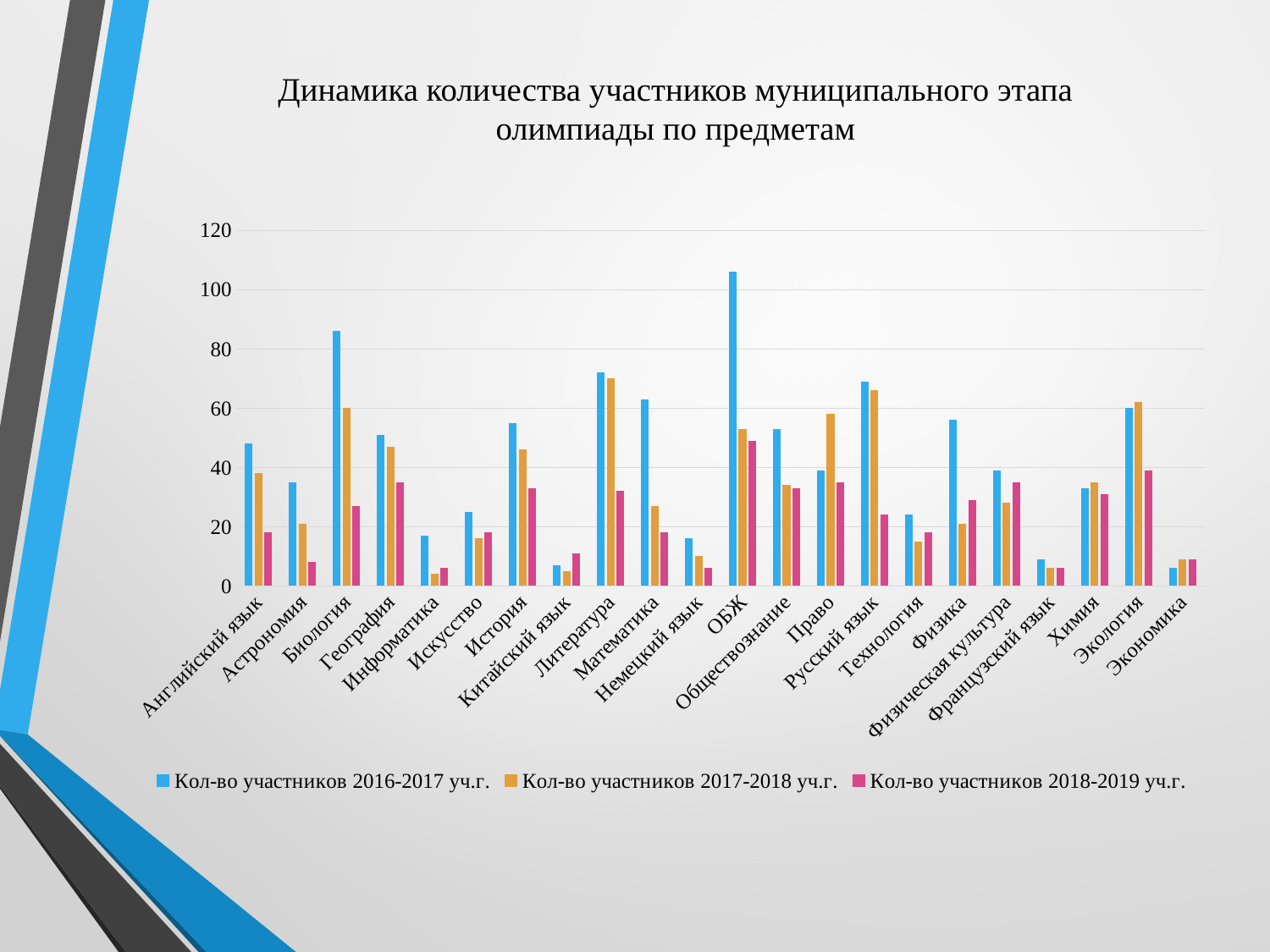
For Право, which series has the larger value: Кол-во участников 2016-2017 уч.г. or Кол-во участников 2017-2018 уч.г.? Кол-во участников 2017-2018 уч.г. Is the value for Право in Кол-во участников 2017-2018 уч.г. greater or less than 40? greater How many subject categories are shown on the x axis? 22 Which is larger for Кол-во участников 2016-2017 уч.г.: Биология or Экология? Биология Which subject has the highest value for Кол-во участников 2018-2019 уч.г.? ОБЖ What is the title of the chart? Динамика количества участников муниципального этапа олимпиады по предметам How many series does the legend list? 3 Is the value for ОБЖ in Кол-во участников 2016-2017 уч.г. greater or less than 100? greater Which subject has the highest value for Кол-во участников 2016-2017 уч.г.? ОБЖ Is the value for Биология in Кол-во участников 2016-2017 уч.г. greater or less than 80? greater What kind of chart is shown on the slide? bar chart